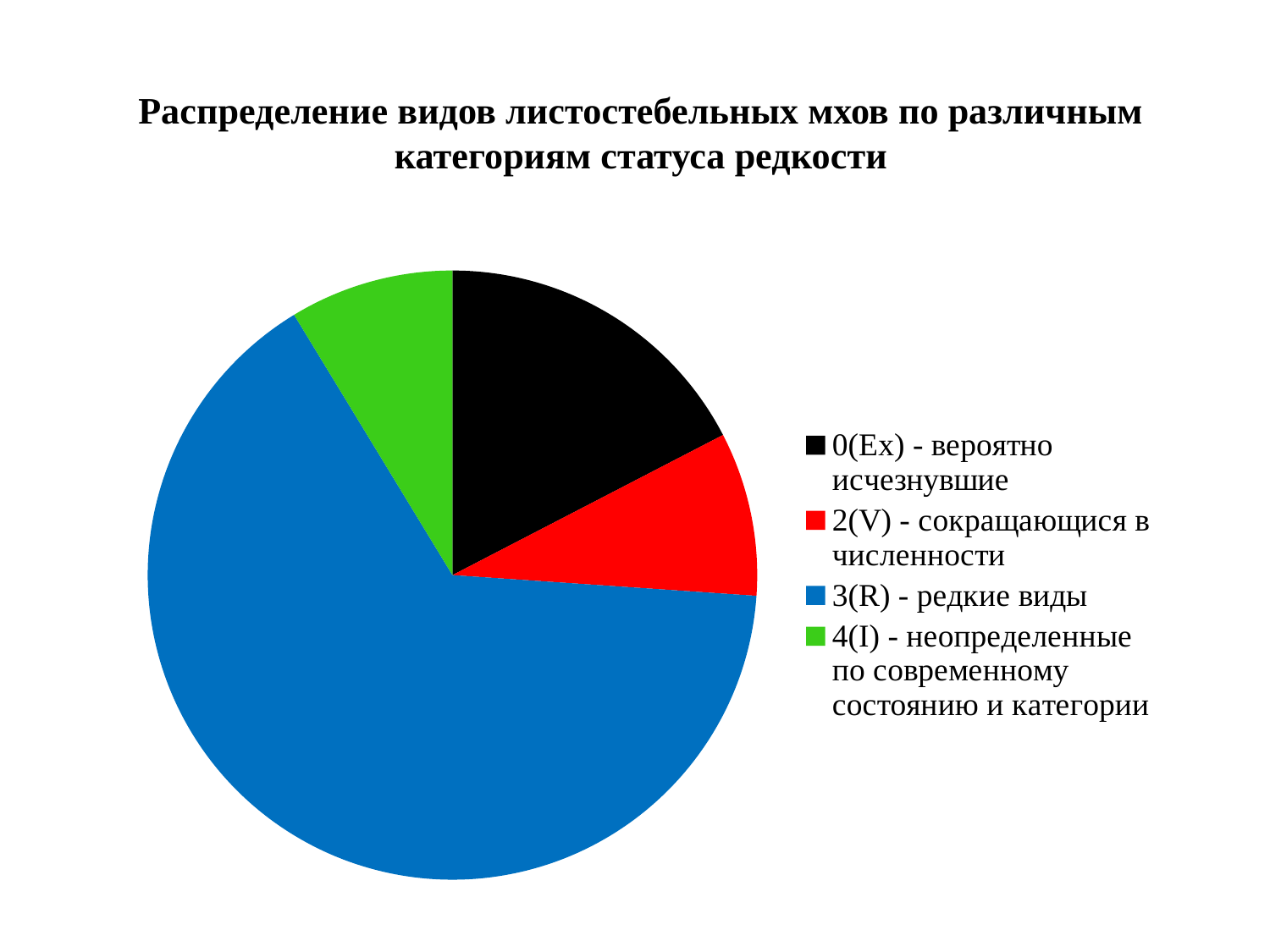
What kind of chart is shown on the slide? pie chart Which slice is larger: 0(Ex) - вероятно исчезнувшие or 2(V) - сокращающиеся в численности? 0(Ex) - вероятно исчезнувшие Which slice is larger: 3(R) - редкие виды or 0(Ex) - вероятно исчезнувшие? 3(R) - редкие виды Which colour represents 3(R) - редкие виды in the pie chart? blue Which category has the largest slice of the pie chart? 3(R) - редкие виды How many categories does the pie chart show? 4 Which slice is larger: 3(R) - редкие виды or 4(I) - неопределенные по современному состоянию и категории? 3(R) - редкие виды What is the title of the chart? Распределение видов листостебельных мхов по различным категориям статуса редкости